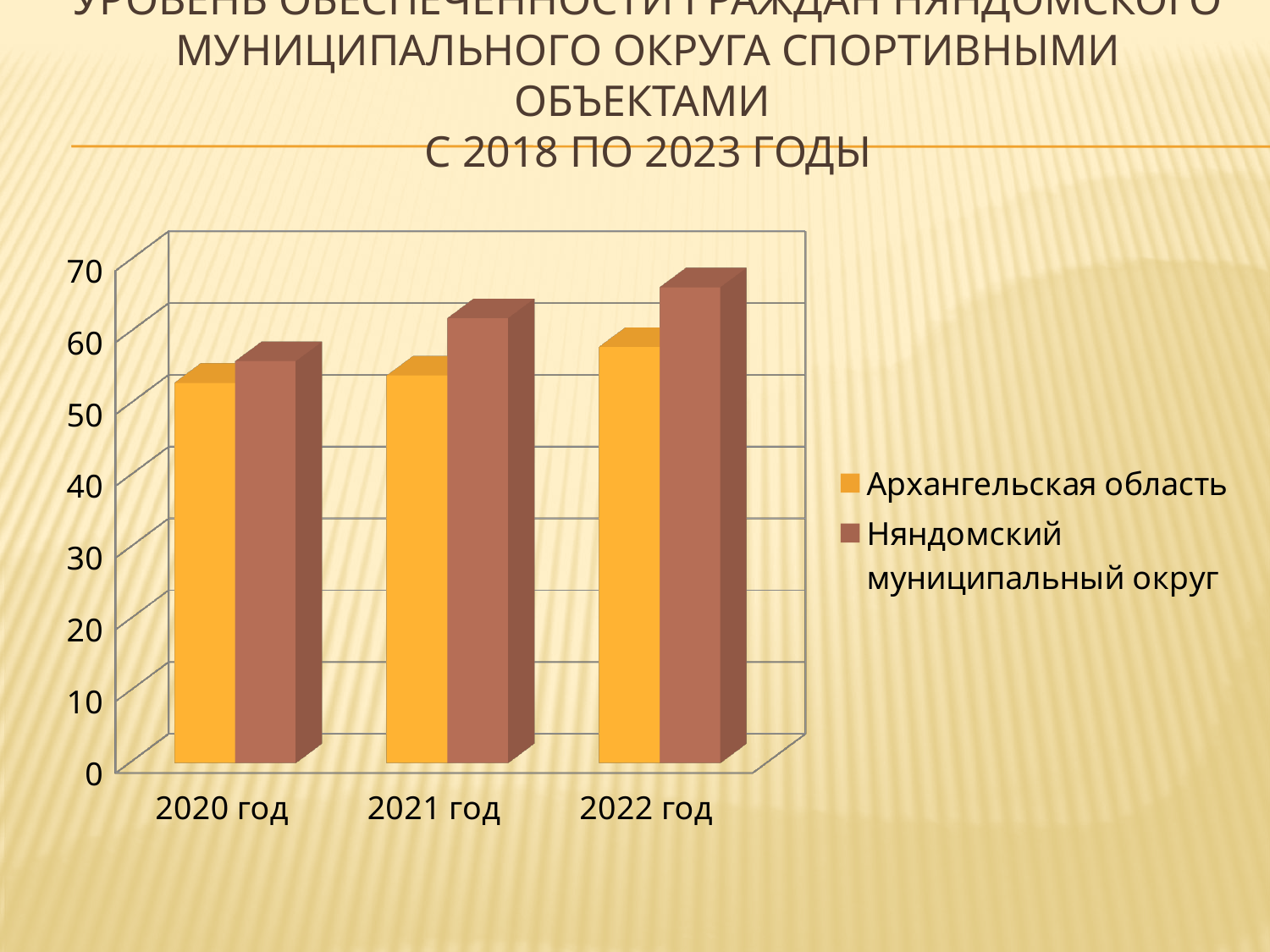
In 2022 год, which series has the larger value: Архангельская область or Няндомский муниципальный округ? Няндомский муниципальный округ In which year is the value for Архангельская область the lowest? 2020 год Is the value for Няндомский муниципальный округ in 2022 год greater or less than 60? greater How many year categories are shown on the x axis? 3 How many series does the legend list? 2 Which series is shown in orange? Архангельская область Which series is shown in brown? Няндомский муниципальный округ Is the value for Архангельская область in 2020 год greater or less than 50? greater Is the value for Няндомский муниципальный округ in 2021 год greater or less than 70? less Do the values for Няндомский муниципальный округ rise or fall from 2020 год to 2022 год? rise What kind of chart is shown on the slide? Bar chart In which year is the value for Няндомский муниципальный округ the highest? 2022 год